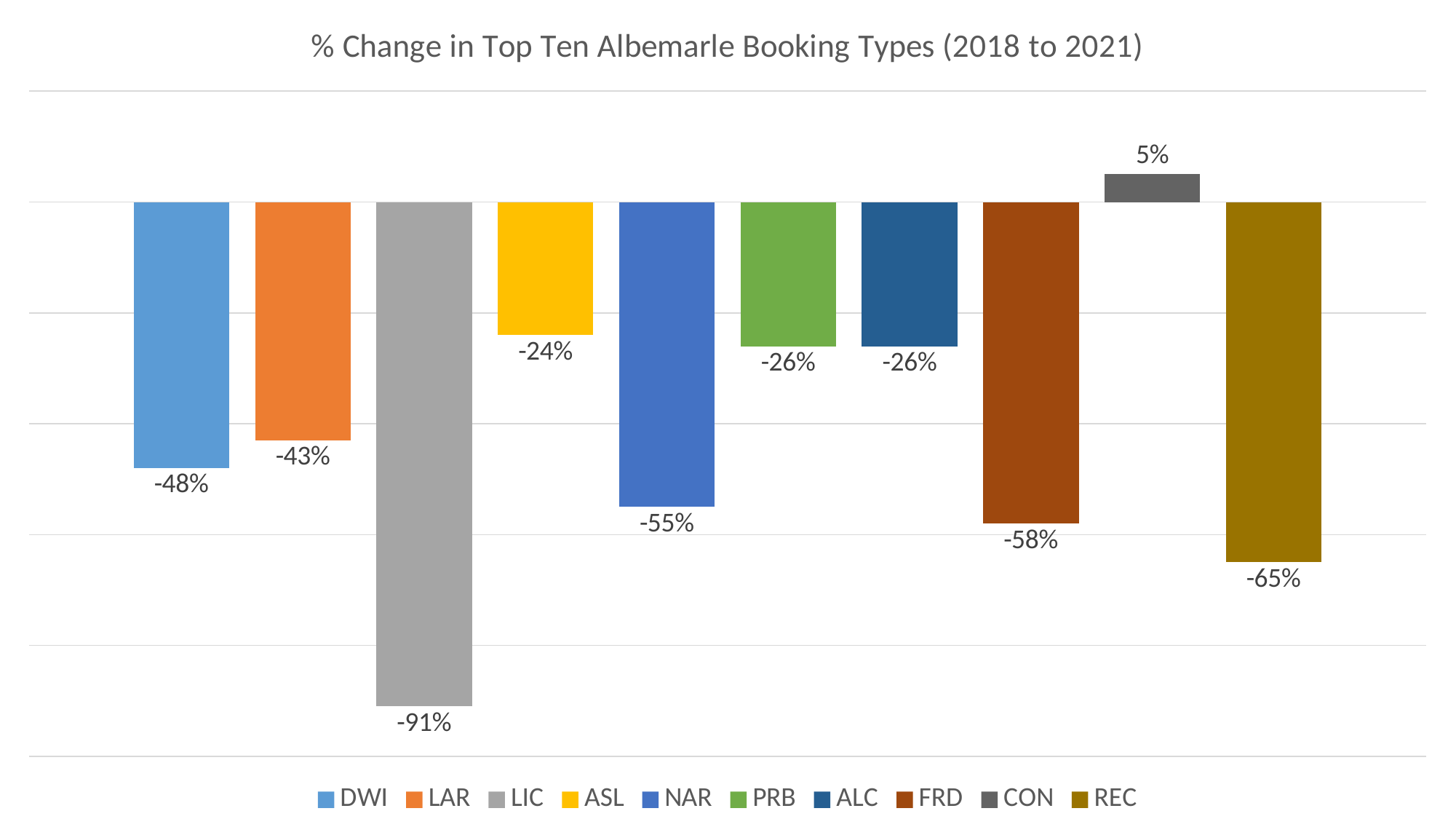
What is the % change for CON? 5% What is the title of the chart? % Change in Top Ten Albemarle Booking Types (2018 to 2021) Which booking type has the highest % change? CON How many booking types are shown in the chart? 10 What is the difference between the % change for DWI and LAR? 5 percentage points What kind of chart is shown on the slide? Bar chart How many entries does the legend list? 10 What is the % change for ASL? -24% What is the % change for LIC? -91% Which booking type has the lowest % change? LIC What is the % change for REC? -65%